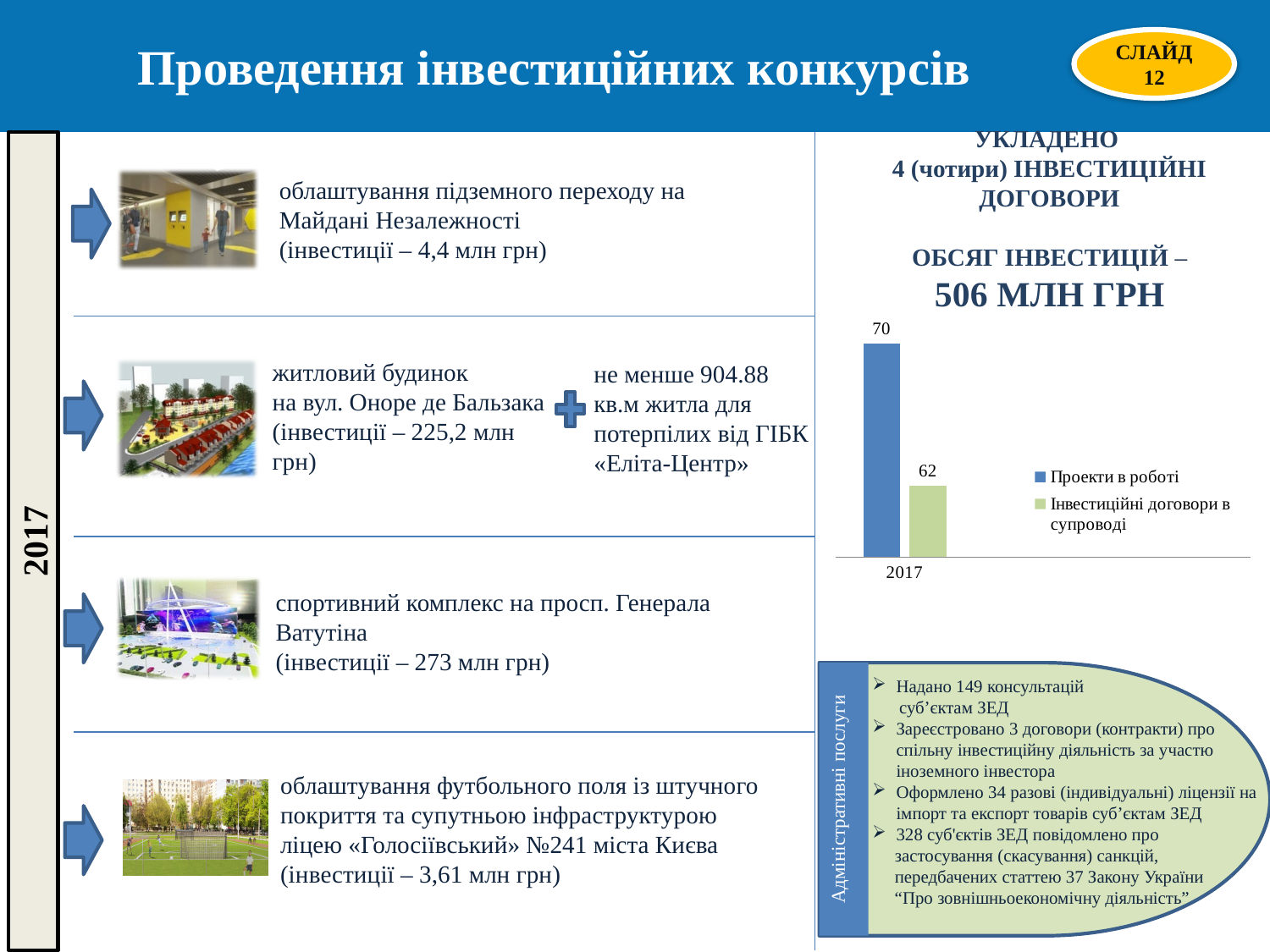
Which series is shown in blue in the chart legend? Проекти в роботі What is the value for "Інвестиційні договори в супроводі" in 2017? 62 What kind of chart is shown on the slide? bar chart Which series has the highest value on the chart? Проекти в роботі Which series has the higher value in 2017, "Проекти в роботі" or "Інвестиційні договори в супроводі"? Проекти в роботі Which series has the lowest value on the chart? Інвестиційні договори в супроводі Which year is shown on the x axis of the chart? 2017 How many categories are shown on the x axis of the chart? 1 How many series does the chart legend list? 2 What is the difference between "Проекти в роботі" and "Інвестиційні договори в супроводі" in 2017? 8 What is the value for "Проекти в роботі" in 2017? 70